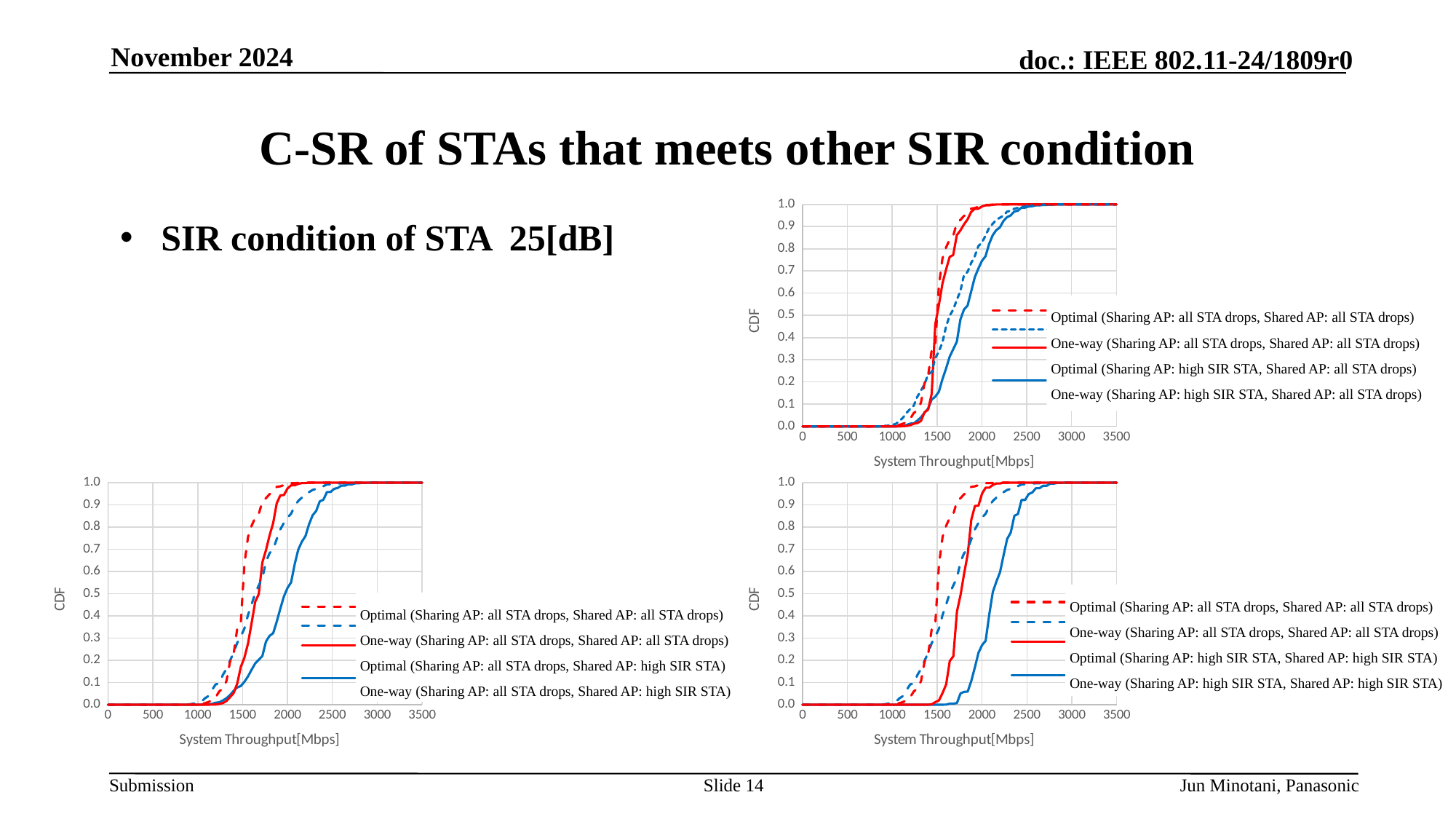
In the top-right chart, do the curves rise or fall as System Throughput increases? Rise In the bottom-right chart, at 2000 Mbps, which curve has the higher CDF value: 'One-way (Sharing AP: all STA drops, Shared AP: all STA drops)' or 'One-way (Sharing AP: high SIR STA, Shared AP: high SIR STA)'? One-way (Sharing AP: all STA drops, Shared AP: all STA drops) What is the maximum value shown on the x axis of the bottom-right chart? 3500 What is the x-axis label of the bottom-left chart? System Throughput[Mbps] In the bottom-left chart, is the CDF value of the 'Optimal (Sharing AP: all STA drops, Shared AP: all STA drops)' curve at 2000 Mbps greater or less than 0.9? greater How many series does the legend of the top-right chart list? 4 In the top-right chart, is the CDF value of the 'One-way (Sharing AP: high SIR STA, Shared AP: all STA drops)' curve at 2500 Mbps greater or less than 0.9? greater In the bottom-right chart, is the CDF value of the 'One-way (Sharing AP: high SIR STA, Shared AP: high SIR STA)' curve at 1500 Mbps greater or less than 0.1? less What is the y-axis label of the top-right chart? CDF What kind of chart is the bottom-left chart on the slide? Line chart How many series does the legend of the bottom-right chart list? 4